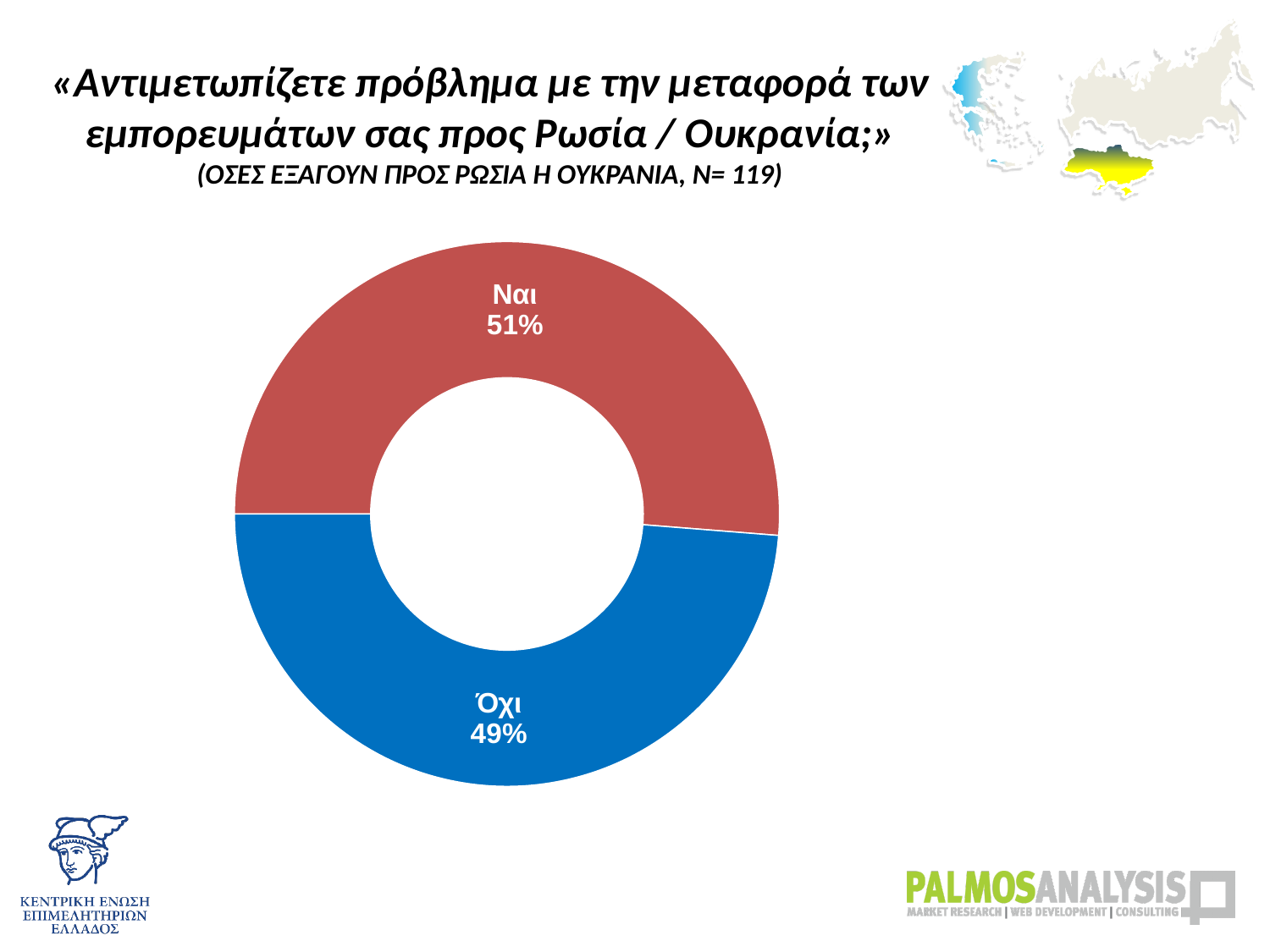
Which response has the larger share of the chart? Ναι Which response has the smaller share of the chart? Όχι What is the difference in percentage points between Ναι and Όχι? 2 What percentage of respondents answered Ναι? 51% How many slices does the chart have? 2 Which is larger, the share for Ναι or the share for Όχι? Ναι What percentage of respondents answered Όχι? 49% What colour is the Ναι slice? red What kind of chart is shown on the slide? doughnut chart What share of the pie does the Όχι slice represent? 49% What is the sample size (N) stated in the chart subtitle? 119 What colour is the Όχι slice? blue